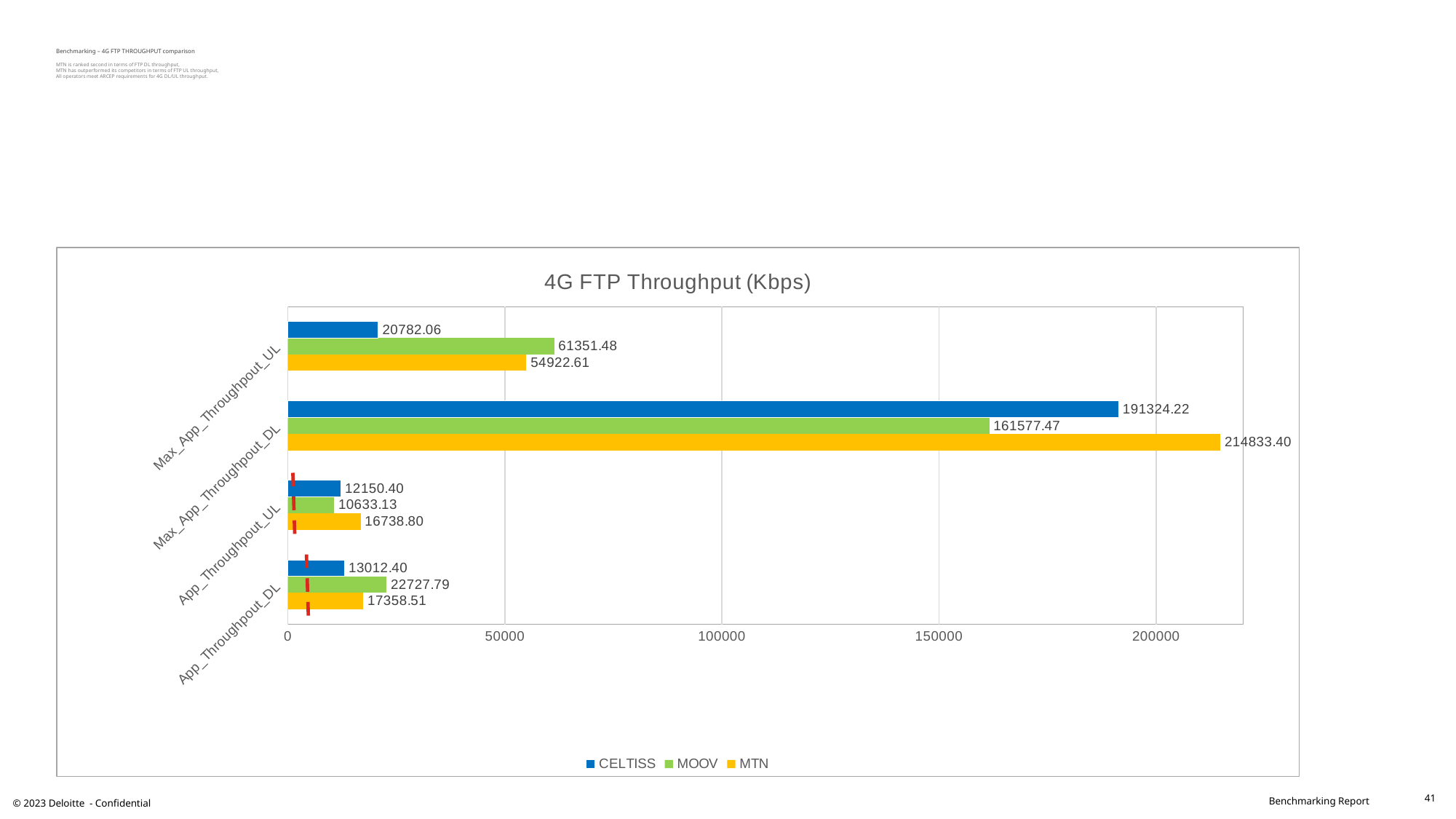
What is the difference between the MTN and CELTISS values for Max_App_Throughpout_DL? 23509.18 What is the MOOV value for App_Throughpout_DL? 22727.79 Which operator has the lowest value for App_Throughpout_UL? MOOV Which operator has the highest value for Max_App_Throughpout_DL? MTN What is the title of the chart? 4G FTP Throughput (Kbps) How many categories are shown on the vertical axis? 4 Is the MOOV value for Max_App_Throughpout_DL greater or less than 150000? greater What is the CELTISS value for Max_App_Throughpout_UL? 20782.06 What type of chart is shown on the slide? Bar chart How many series does the legend list? 3 What is the MTN value for Max_App_Throughpout_DL? 214833.40 Which is larger for Max_App_Throughpout_UL: the MOOV value or the MTN value? MOOV